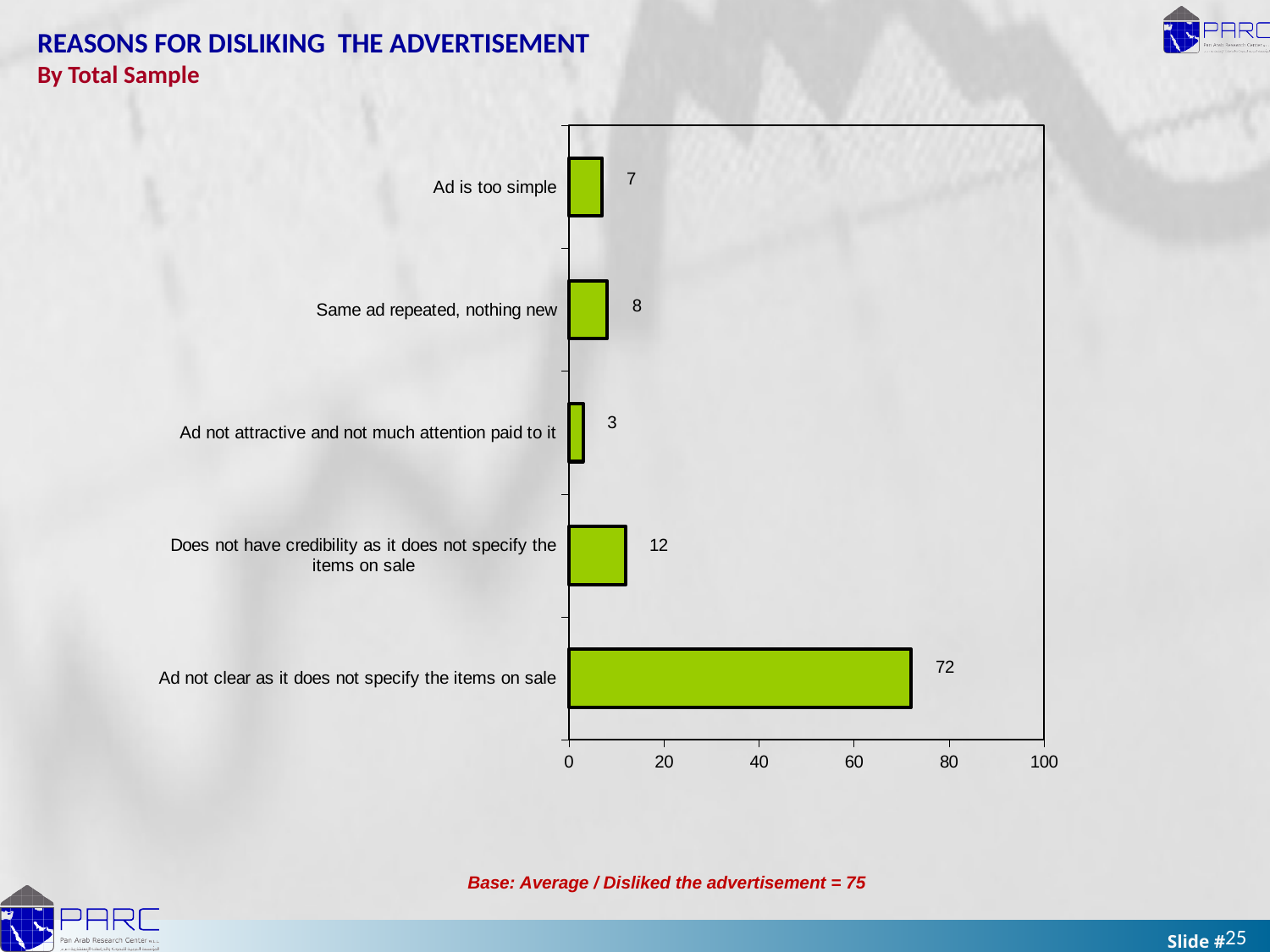
What is the value for "Same ad repeated, nothing new"? 8 Which reason has the lowest value? Ad not attractive and not much attention paid to it What is the value for "Ad not clear as it does not specify the items on sale"? 72 What is the difference between the values for "Ad not clear as it does not specify the items on sale" and "Does not have credibility as it does not specify the items on sale"? 60 Which reason has the highest value? Ad not clear as it does not specify the items on sale What is the value for "Ad is too simple"? 7 Is the value for "Ad not clear as it does not specify the items on sale" greater or less than 60? greater What is the base stated below the chart? Average / Disliked the advertisement = 75 What kind of chart is shown on the slide? Bar chart How many reasons are shown in the chart? 5 Which is larger, the value for "Same ad repeated, nothing new" or the value for "Ad is too simple"? Same ad repeated, nothing new What is the value for "Does not have credibility as it does not specify the items on sale"? 12